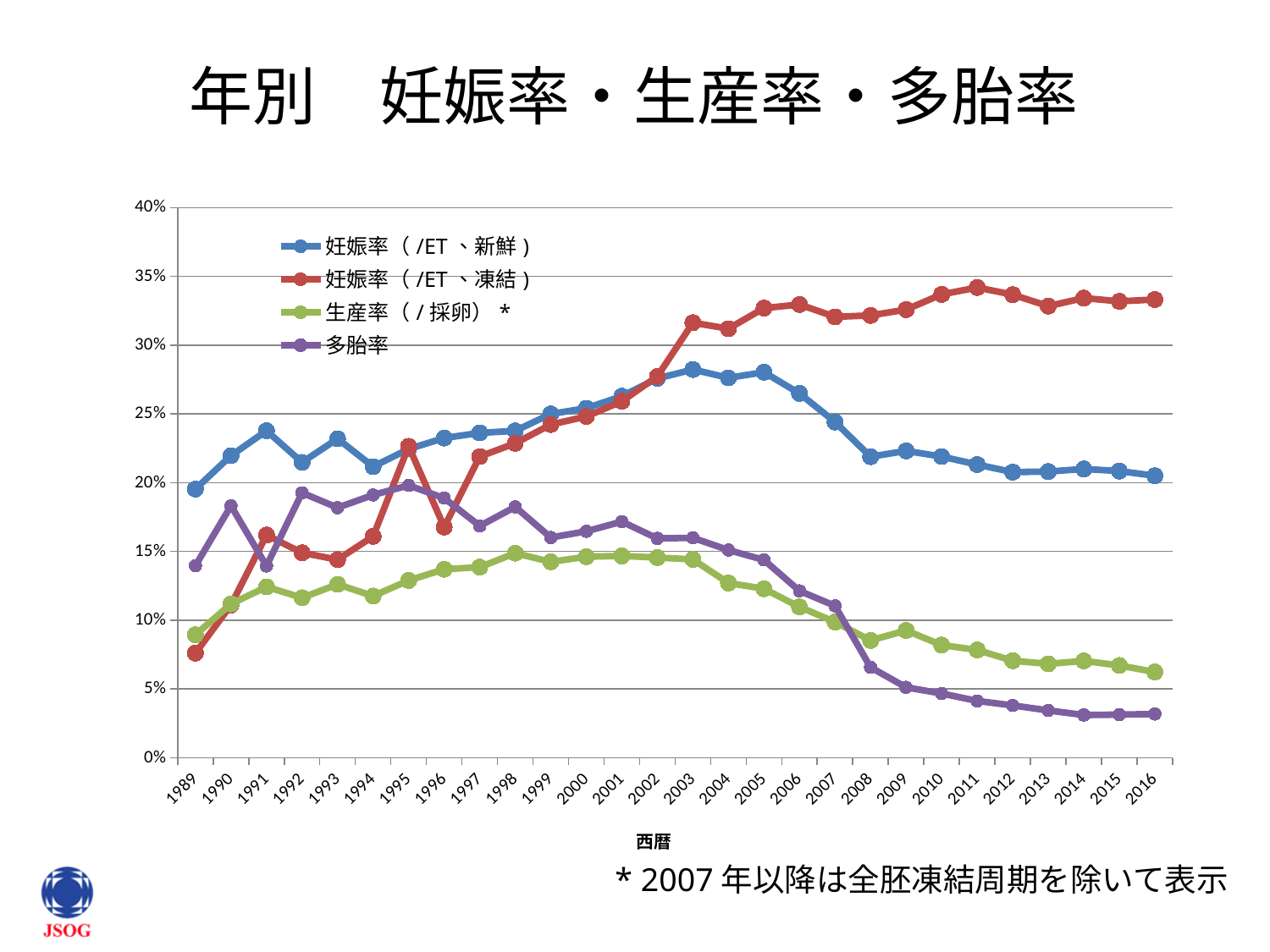
Is the value for 妊娠率（/ET、新鮮） in 2003 greater or less than 25%? greater Which series has the lowest value in 2016? 多胎率 How many series does the legend list? 4 Is the value for 妊娠率（/ET、凍結） in 2011 greater or less than 30%? greater Does 妊娠率（/ET、凍結） rise or fall from 1997 to 2003? rise Is the value for 多胎率 in 2016 greater or less than 5%? less What kind of chart is shown on the slide? line chart How many years are plotted along the x axis? 28 What is the x-axis title of the chart? 西暦 Does 多胎率 rise or fall from 2003 to 2016? fall In 2016, which is higher: 妊娠率（/ET、新鮮） or 妊娠率（/ET、凍結）? 妊娠率（/ET、凍結）